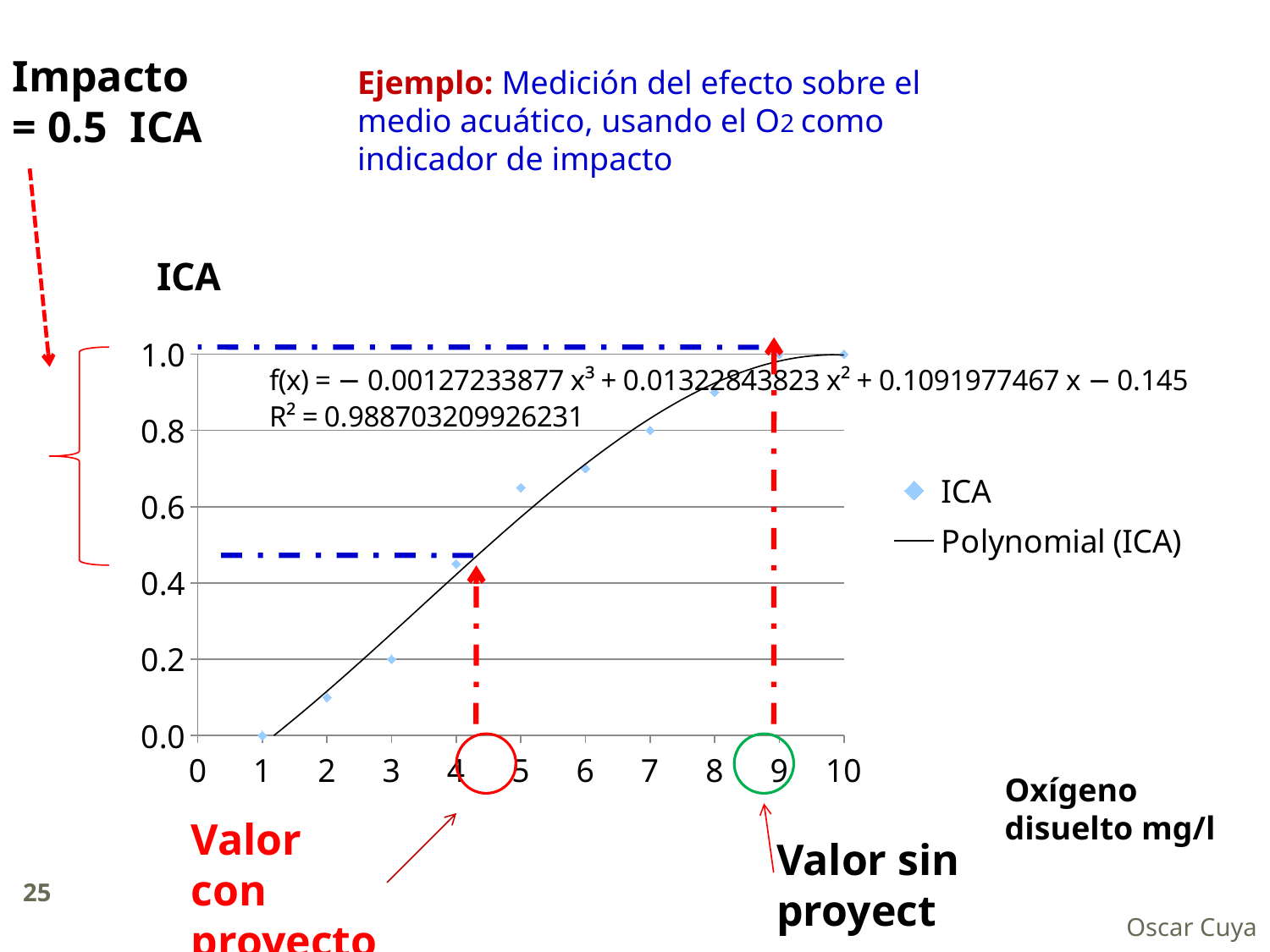
What R² value is printed on the chart? 0.988703209926231 What are the two entries in the chart legend? ICA and Polynomial (ICA) Do the ICA values rise or fall as dissolved oxygen increases along the x axis? rise At which oxygen level is the ICA value lowest? 1 Is the ICA value at an oxygen level of 2 greater or less than 0.2? less How many series does the legend list? 2 What is the ICA value at an oxygen level of 10? 1.0 What is the ICA value at an oxygen level of 1? 0.0 What kind of chart is shown on the slide? scatter chart What is the ICA value at an oxygen level of 3? 0.2 Is the ICA value at an oxygen level of 5 greater or less than 0.6? greater